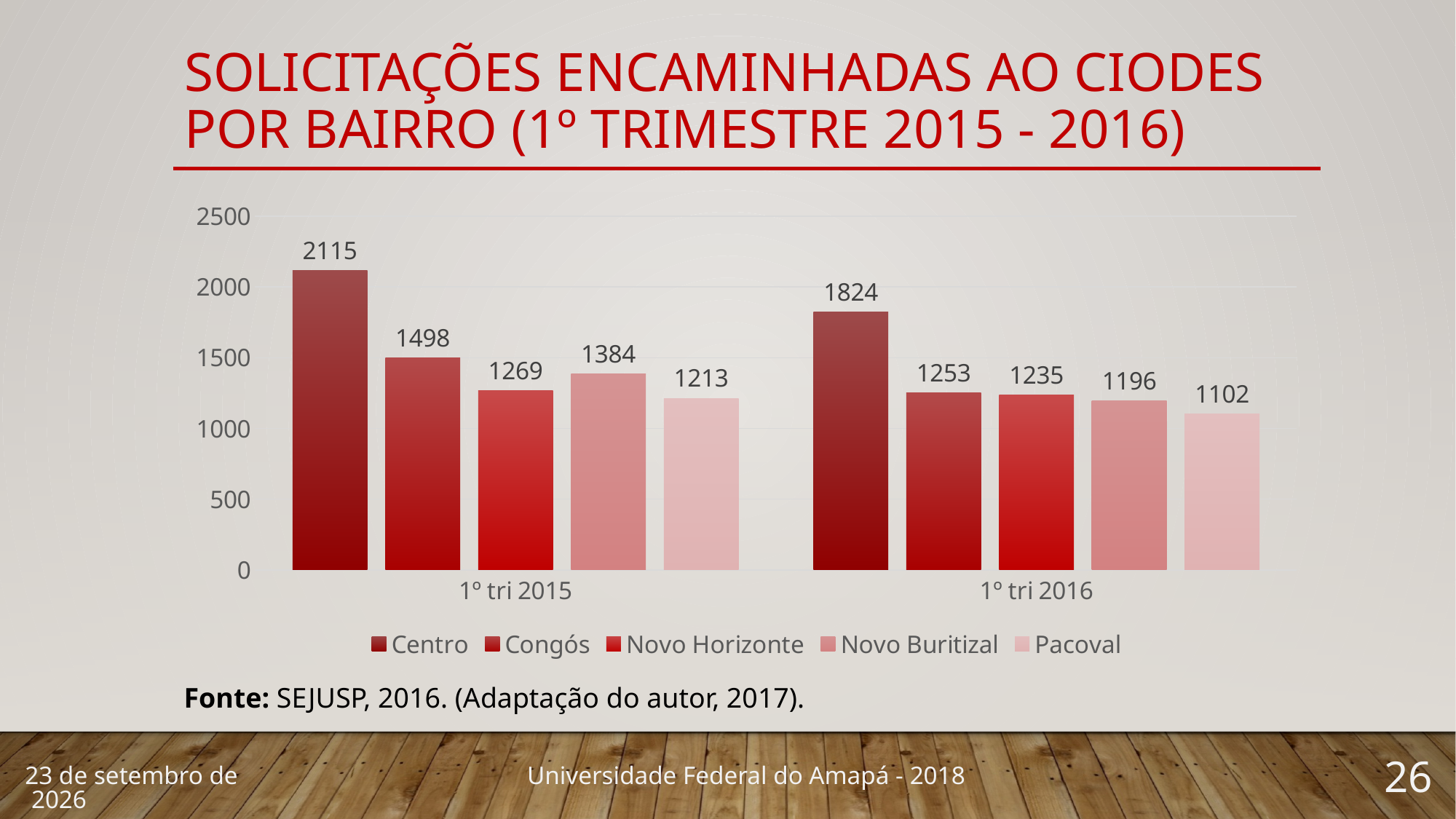
How many categories are shown on the x axis? 2 Is the value for Centro in 1º tri 2015 greater or less than 2000? greater What is the value for Novo Buritizal in 1º tri 2015? 1384 Does the value for Novo Horizonte rise or fall from 1º tri 2015 to 1º tri 2016? Fall What is the value for Pacoval in 1º tri 2016? 1102 Which is larger: Congós in 1º tri 2015 or Novo Buritizal in 1º tri 2015? Congós in 1º tri 2015 Which series has the lowest value in 1º tri 2015? Pacoval What is the value for Centro in 1º tri 2015? 2115 How many series does the legend list? 5 What is the difference between the Centro values for 1º tri 2015 and 1º tri 2016? 291 What kind of chart is shown on the slide? Bar chart Which series has the highest value in 1º tri 2016? Centro